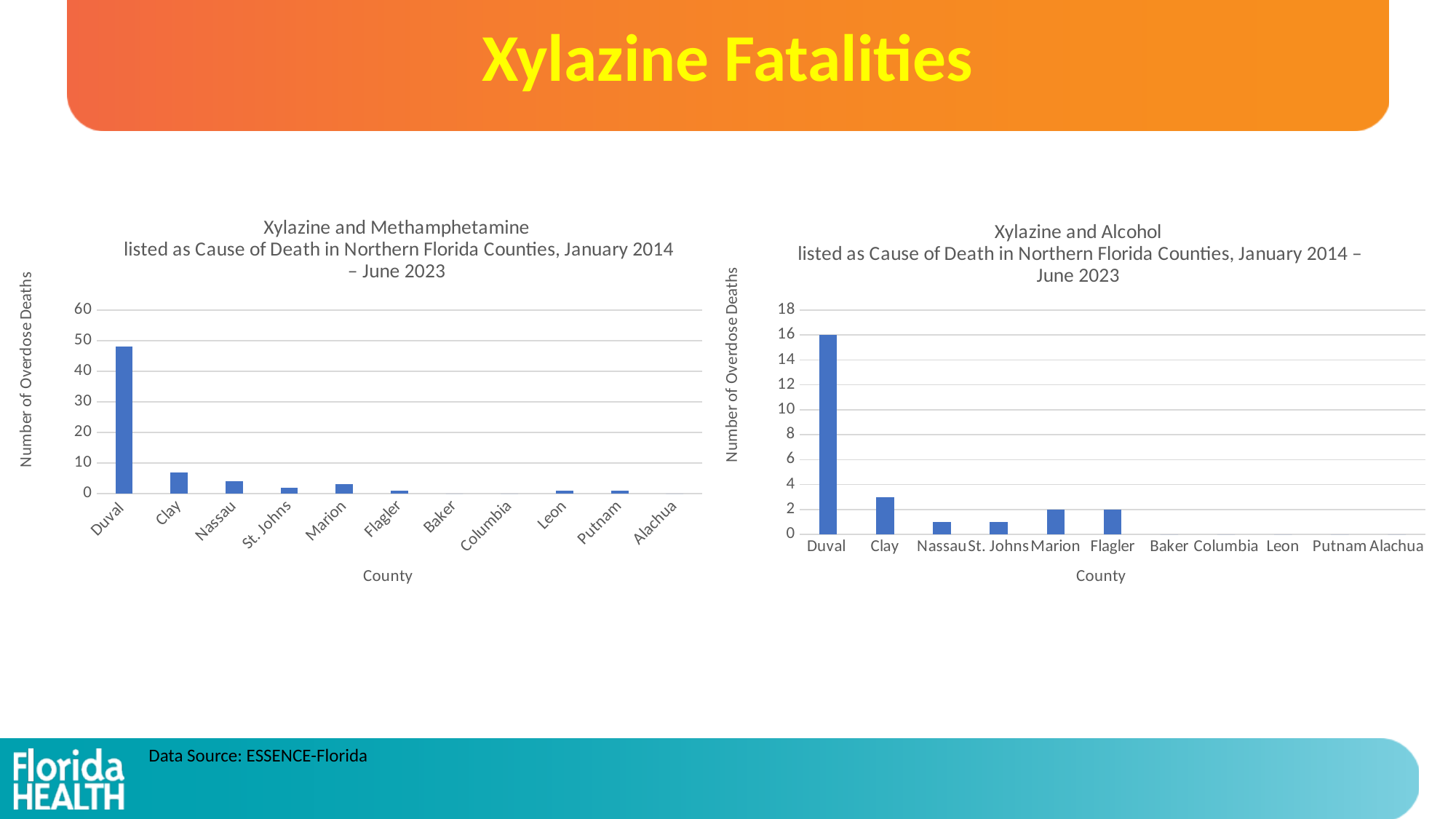
In the 'Xylazine and Methamphetamine' chart on the left, which county has more overdose deaths, Clay or Nassau? Clay In the 'Xylazine and Alcohol' chart on the right, what is the number of overdose deaths for Marion? 2 In the 'Xylazine and Alcohol' chart on the right, is the value for Clay greater or less than 2? greater In the 'Xylazine and Alcohol' chart on the right, what is the number of overdose deaths for Duval? 16 In the 'Xylazine and Methamphetamine' chart on the left, which county has the highest number of overdose deaths? Duval In the 'Xylazine and Alcohol' chart on the right, what is the difference between the values for Duval and Flagler? 14 In the 'Xylazine and Methamphetamine' chart on the left, is the value for Clay greater or less than 10? less In the 'Xylazine and Alcohol' chart on the right, how many counties are shown on the x axis? 11 What is the y-axis title of the 'Xylazine and Alcohol' chart on the right? Number of Overdose Deaths In the 'Xylazine and Alcohol' chart on the right, which county has the highest number of overdose deaths? Duval What kind of chart is the 'Xylazine and Methamphetamine' chart on the left? Bar chart In the 'Xylazine and Methamphetamine' chart on the left, is the value for Duval greater or less than 40? greater